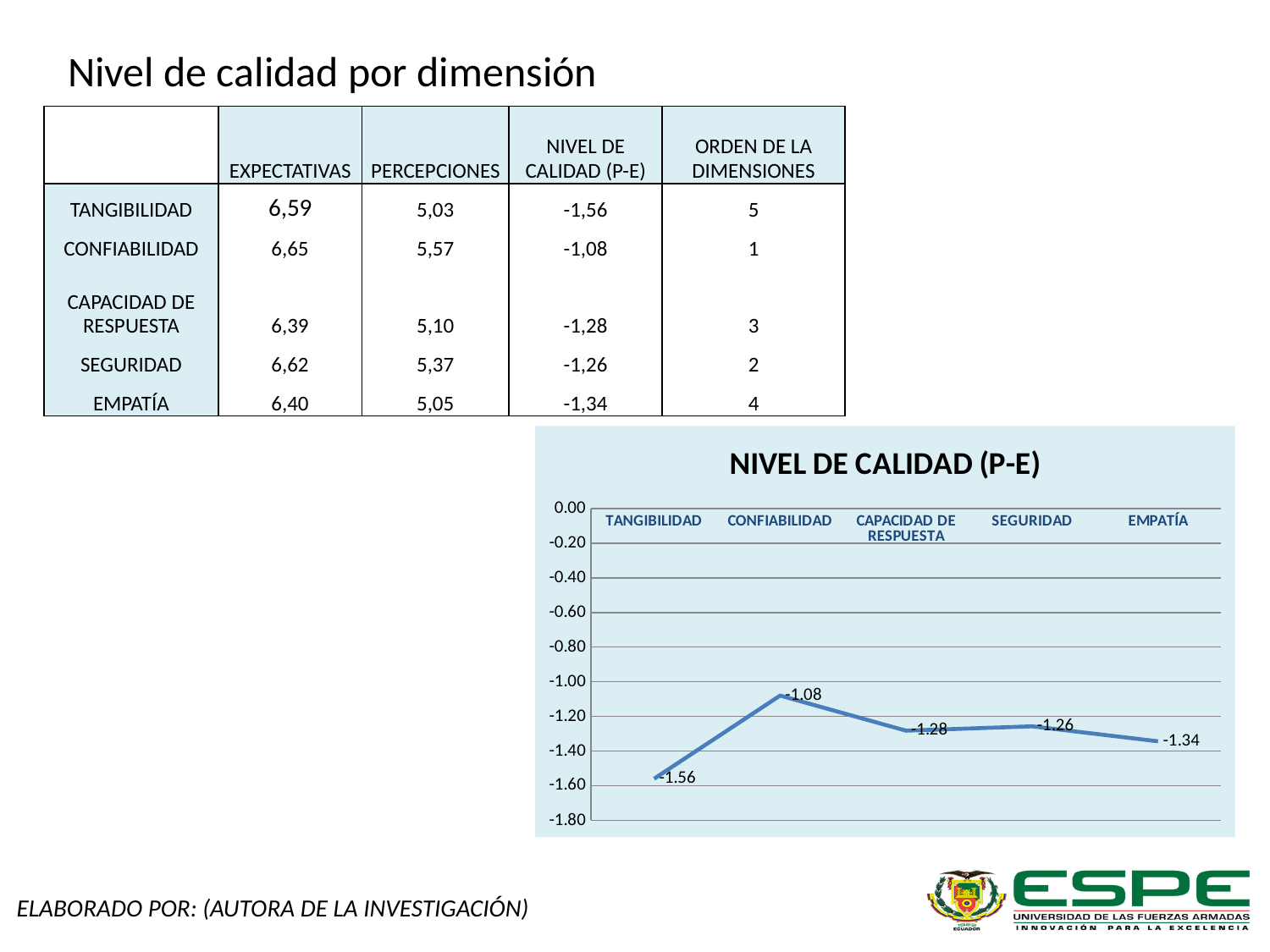
What is the difference between the values for CONFIABILIDAD and TANGIBILIDAD in the chart? 0.48 What is the value for TANGIBILIDAD in the chart? -1.56 What type of chart is shown on the slide? Line chart Is the value for TANGIBILIDAD in the chart greater or less than -1.40? less What is the value for CONFIABILIDAD in the chart? -1.08 What is the value for CAPACIDAD DE RESPUESTA in the chart? -1.28 How many categories are plotted in the chart? 5 What is the value for EMPATÍA in the chart? -1.34 Which category has the highest value in the chart? CONFIABILIDAD What is the title of the chart? NIVEL DE CALIDAD (P-E) Which category has the lowest value in the chart? TANGIBILIDAD Which has a higher value in the chart, SEGURIDAD or EMPATÍA? SEGURIDAD